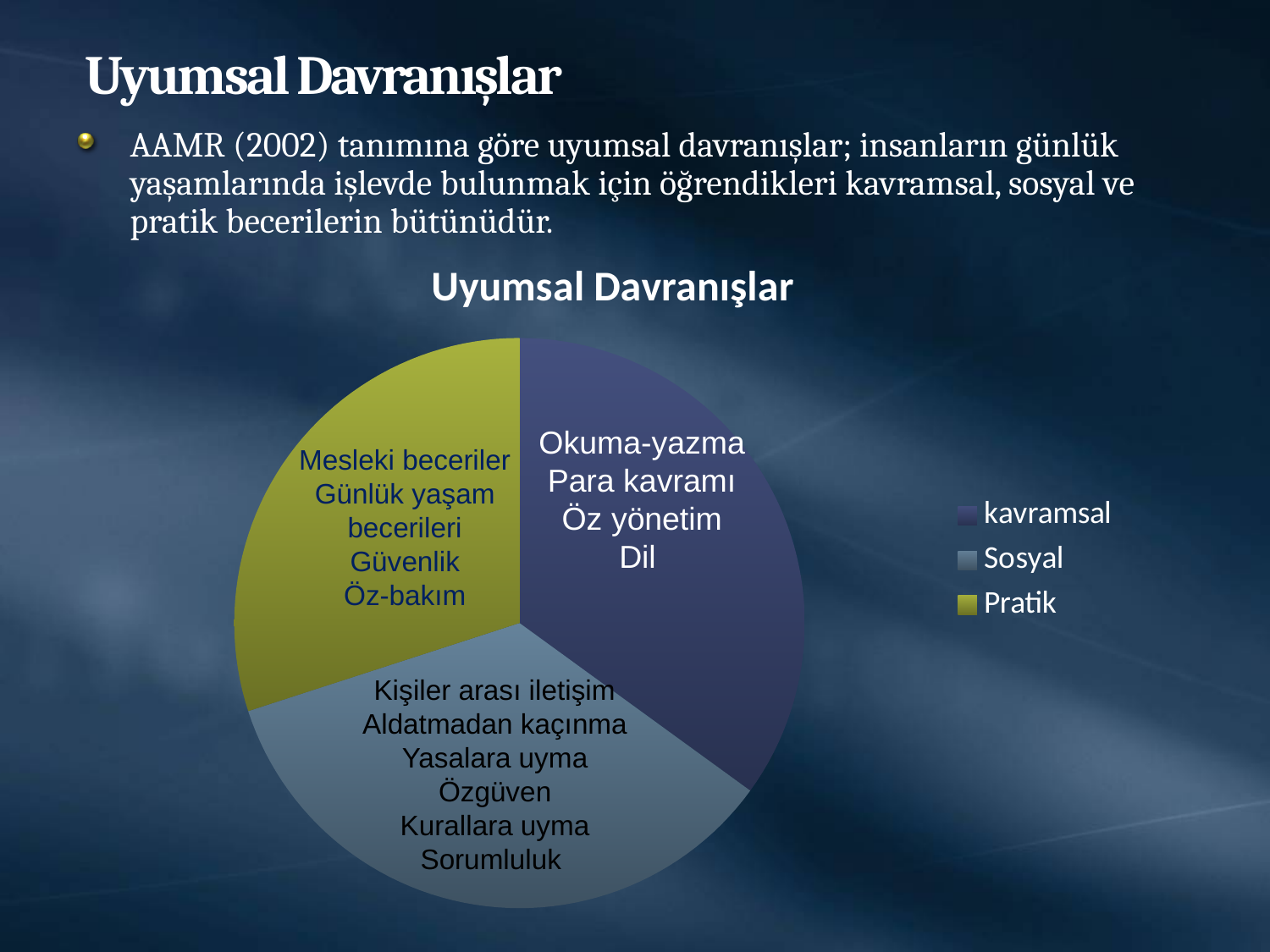
How many entries does the legend of the pie chart list? 3 Which slice of the pie chart contains the text 'Mesleki beceriler, Günlük yaşam becerileri, Güvenlik, Öz-bakım'? Pratik Which slice of the pie chart lists 'Kişiler arası iletişim' and 'Sorumluluk'? Sosyal What is the title of the pie chart? Uyumsal Davranışlar Which legend entry is shown in yellow-green in the pie chart? Pratik What kind of chart is shown on the slide? pie chart Which slice of the pie chart contains the text 'Okuma-yazma, Para kavramı, Öz yönetim, Dil'? kavramsal How many slices does the pie chart have? 3